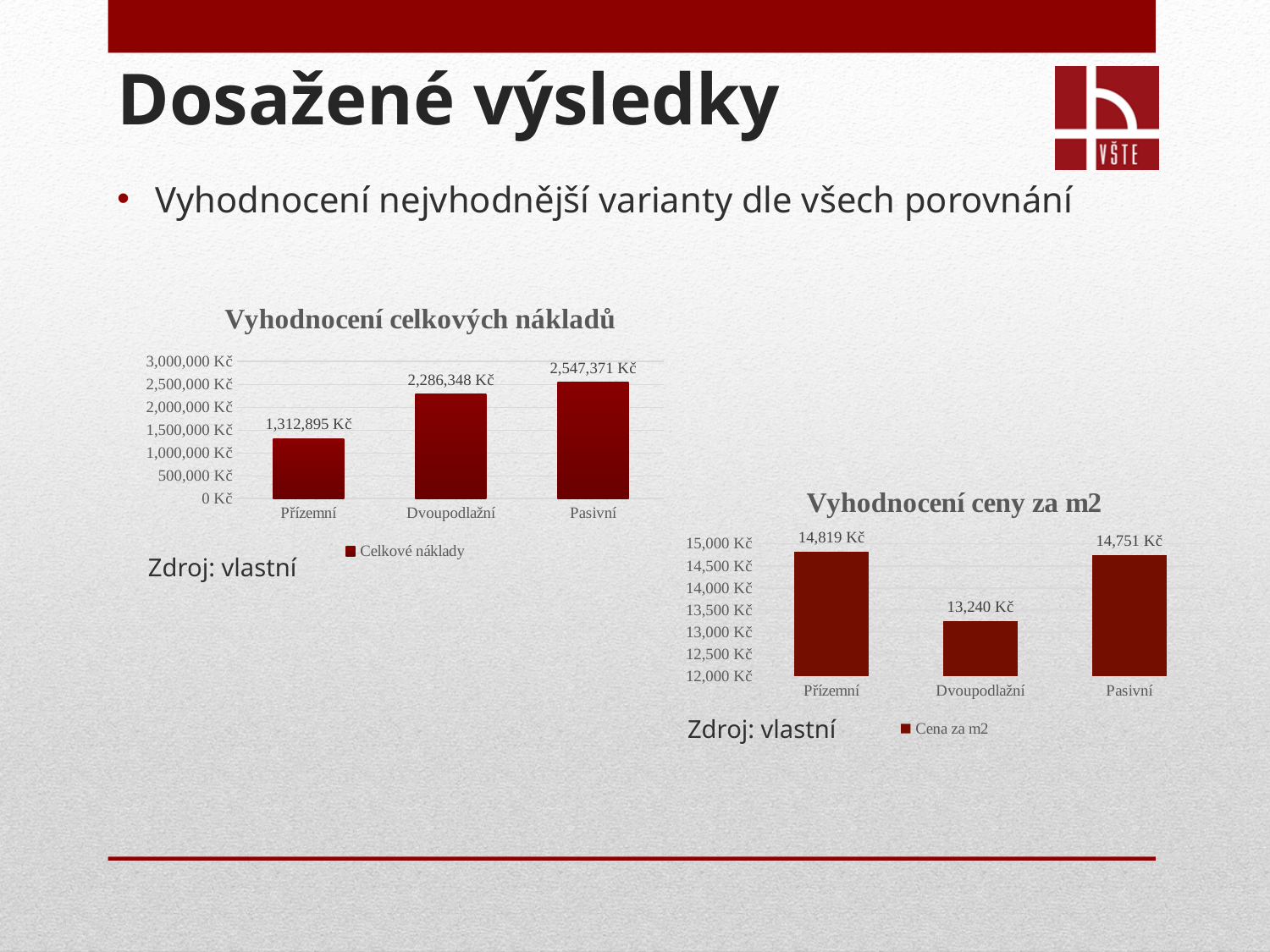
In the chart 'Vyhodnocení ceny za m2', what is the difference between the values for Přízemní and Dvoupodlažní? 1,579 Kč In the chart 'Vyhodnocení celkových nákladů', which category has the highest value? Pasivní In the chart 'Vyhodnocení ceny za m2', what is the value for Dvoupodlažní? 13,240 Kč In the chart 'Vyhodnocení ceny za m2', how many categories are shown on the x axis? 3 In the chart 'Vyhodnocení ceny za m2', which category has the lowest value? Dvoupodlažní In the chart 'Vyhodnocení celkových nákladů', what kind of chart is shown? Bar chart In the chart 'Vyhodnocení celkových nákladů', which category has the lowest value? Přízemní In the chart 'Vyhodnocení ceny za m2', what series name does the legend show? Cena za m2 In the chart 'Vyhodnocení celkových nákladů', what is the difference between the values for Pasivní and Přízemní? 1,234,476 Kč In the chart 'Vyhodnocení ceny za m2', what is the value for Pasivní? 14,751 Kč In the chart 'Vyhodnocení celkových nákladů', what is the value for Přízemní? 1,312,895 Kč In the chart 'Vyhodnocení celkových nákladů', what is the value for Dvoupodlažní? 2,286,348 Kč